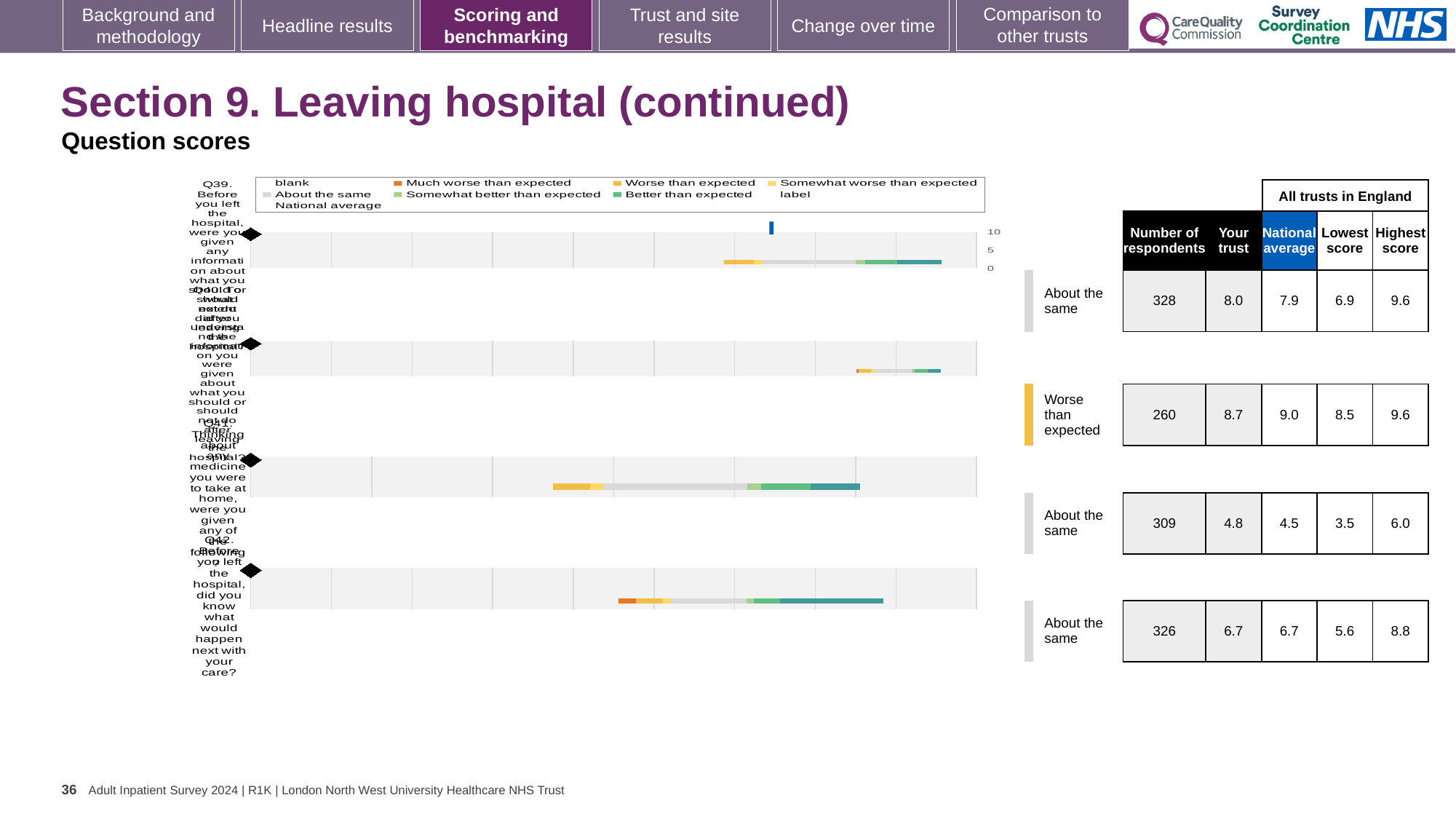
What colour represents 'Better than expected' in the chart legend? teal green In the table beside the chart, what is the difference between the national average and the 'Your trust' score in the second row? 0.3 What kind of chart is shown on the slide? bar chart In the table beside the chart, what is the lowest score for the third row? 3.5 In the table beside the chart, what is the highest score for the second row? 9.6 In the table beside the chart, what is the number of respondents for the first row (Q39)? 328 In the table beside the chart, which row has the lowest 'Your trust' score? the third row (4.8) How many entries does the chart legend list? 9 In the table beside the chart, for the first row (Q39), which is larger: the 'Your trust' score or the national average? Your trust In the table beside the chart, what is the 'Your trust' score for the first row (Q39)? 8.0 How many question bars are plotted in the chart? 4 What colour represents 'Much worse than expected' in the chart legend? orange